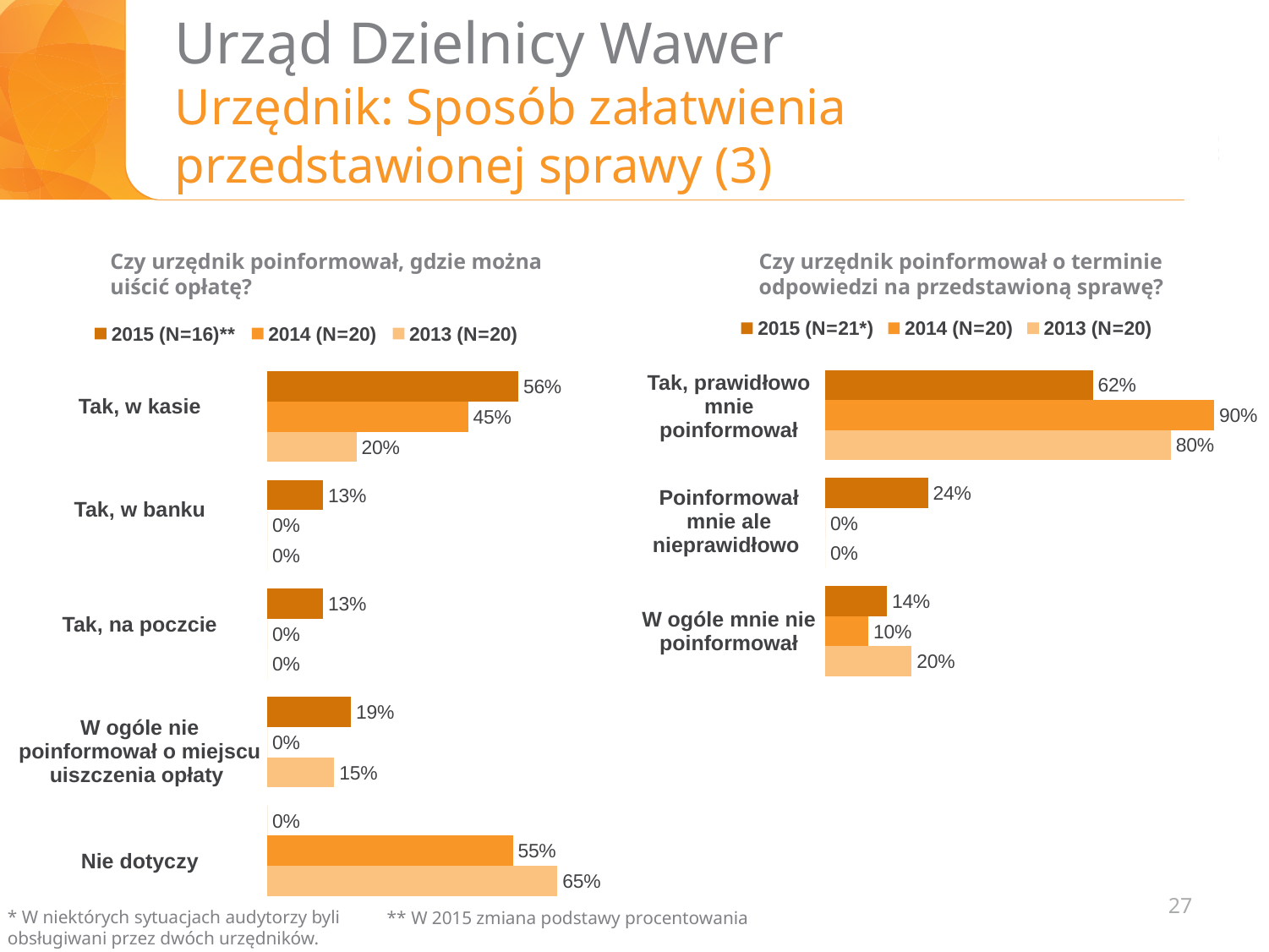
In the right chart ("Czy urzędnik poinformował o terminie odpowiedzi na przedstawioną sprawę?"), what is the sample size shown in the legend for the 2015 series? N=21* In the left chart ("Czy urzędnik poinformował, gdzie można uiścić opłatę?"), how many series does the legend list? 3 In the left chart ("Czy urzędnik poinformował, gdzie można uiścić opłatę?"), which category has the highest value in the 2014 series? Nie dotyczy In the right chart ("Czy urzędnik poinformował o terminie odpowiedzi na przedstawioną sprawę?"), what is the value for "Poinformował mnie ale nieprawidłowo" in the 2015 series? 24% In the right chart ("Czy urzędnik poinformował o terminie odpowiedzi na przedstawioną sprawę?"), which is larger for "W ogóle mnie nie poinformował": the 2015 value or the 2013 value? 2013 In the left chart ("Czy urzędnik poinformował, gdzie można uiścić opłatę?"), what is the value for "Tak, w kasie" in the 2015 series? 56% In the right chart ("Czy urzędnik poinformował o terminie odpowiedzi na przedstawioną sprawę?"), what is the value for "Tak, prawidłowo mnie poinformował" in the 2014 series? 90% In the left chart ("Czy urzędnik poinformował, gdzie można uiścić opłatę?"), what is the value for "Nie dotyczy" in the 2013 series? 65% In the left chart ("Czy urzędnik poinformował, gdzie można uiścić opłatę?"), what is the difference between the 2015 and 2013 values for "Tak, w kasie"? 36 percentage points In the left chart ("Czy urzędnik poinformował, gdzie można uiścić opłatę?"), how many categories are shown? 5 In the right chart ("Czy urzędnik poinformował o terminie odpowiedzi na przedstawioną sprawę?"), what is the difference between the 2014 and 2015 values for "Tak, prawidłowo mnie poinformował"? 28 percentage points What type of chart is the right chart ("Czy urzędnik poinformował o terminie odpowiedzi na przedstawioną sprawę?")? Bar chart